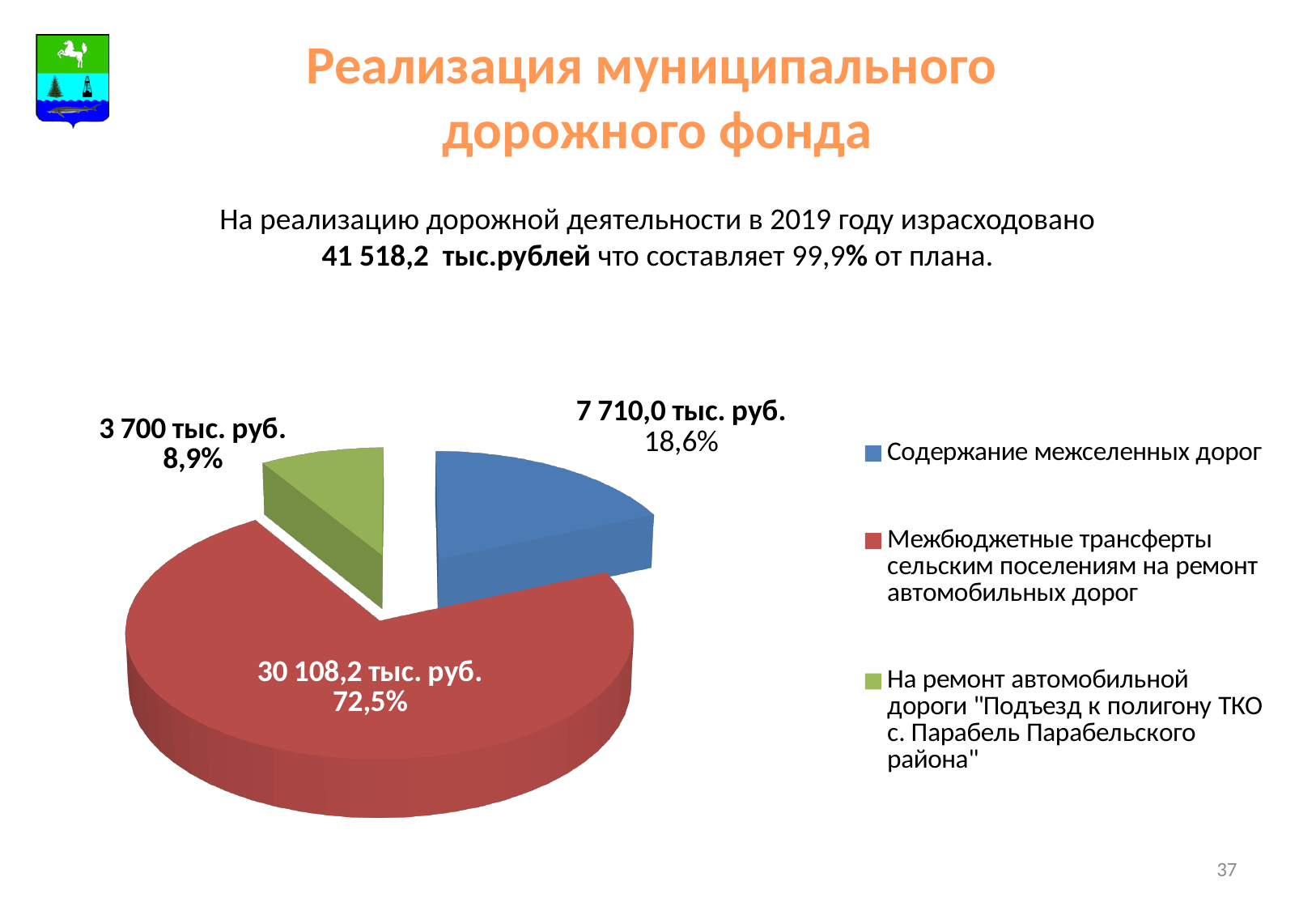
Which is larger in the pie chart: the value for "Содержание межселенных дорог" or the value for "На ремонт автомобильной дороги "Подъезд к полигону ТКО с. Парабель Парабельского района""? Содержание межселенных дорог What is the value for "Содержание межселенных дорог" in the pie chart? 7 710,0 тыс. руб. What is the value for "На ремонт автомобильной дороги "Подъезд к полигону ТКО с. Парабель Парабельского района"" in the pie chart? 3 700 тыс. руб. What share of the pie does "Содержание межселенных дорог" represent? 18,6% What share of the pie does "Межбюджетные трансферты сельским поселениям на ремонт автомобильных дорог" represent? 72,5% What kind of chart is shown on the slide? pie chart Which category has the largest slice in the pie chart? Межбюджетные трансферты сельским поселениям на ремонт автомобильных дорог What colour is the slice for "Межбюджетные трансферты сельским поселениям на ремонт автомобильных дорог" in the pie chart? red How many slices does the pie chart have? 3 What is the value for "Межбюджетные трансферты сельским поселениям на ремонт автомобильных дорог" in the pie chart? 30 108,2 тыс. руб. How many entries does the legend of the pie chart list? 3 Which category has the smallest slice in the pie chart? На ремонт автомобильной дороги "Подъезд к полигону ТКО с. Парабель Парабельского района"